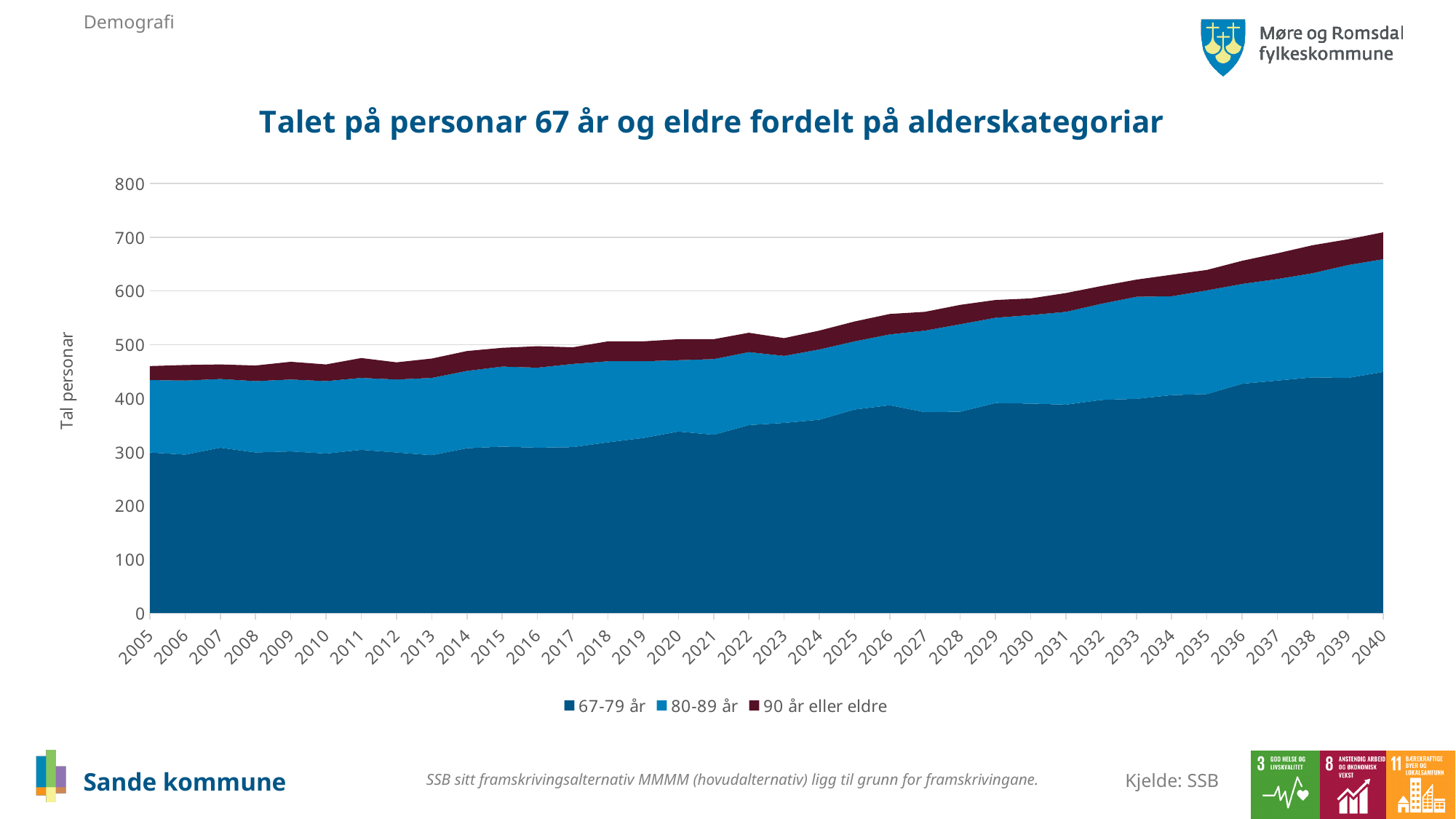
Which year has the highest total number of persons 67 years and older? 2040 Does the total number of persons 67 years and older rise or fall from 2005 to 2040? Rise How many years are shown along the x axis? 36 Is the total for all age categories in 2025 greater or less than 500? greater What is the title of the chart? Talet på personar 67 år og eldre fordelt på alderskategoriar Is the total for all age categories in 2040 greater or less than 600? greater Is the total for all age categories in 2005 greater or less than 500? less What is the label on the y axis? Tal personar How many series does the legend list? 3 What kind of chart is shown on the slide? Stacked area chart Which is larger, the total number of persons 67 years and older in 2040 or in 2005? 2040